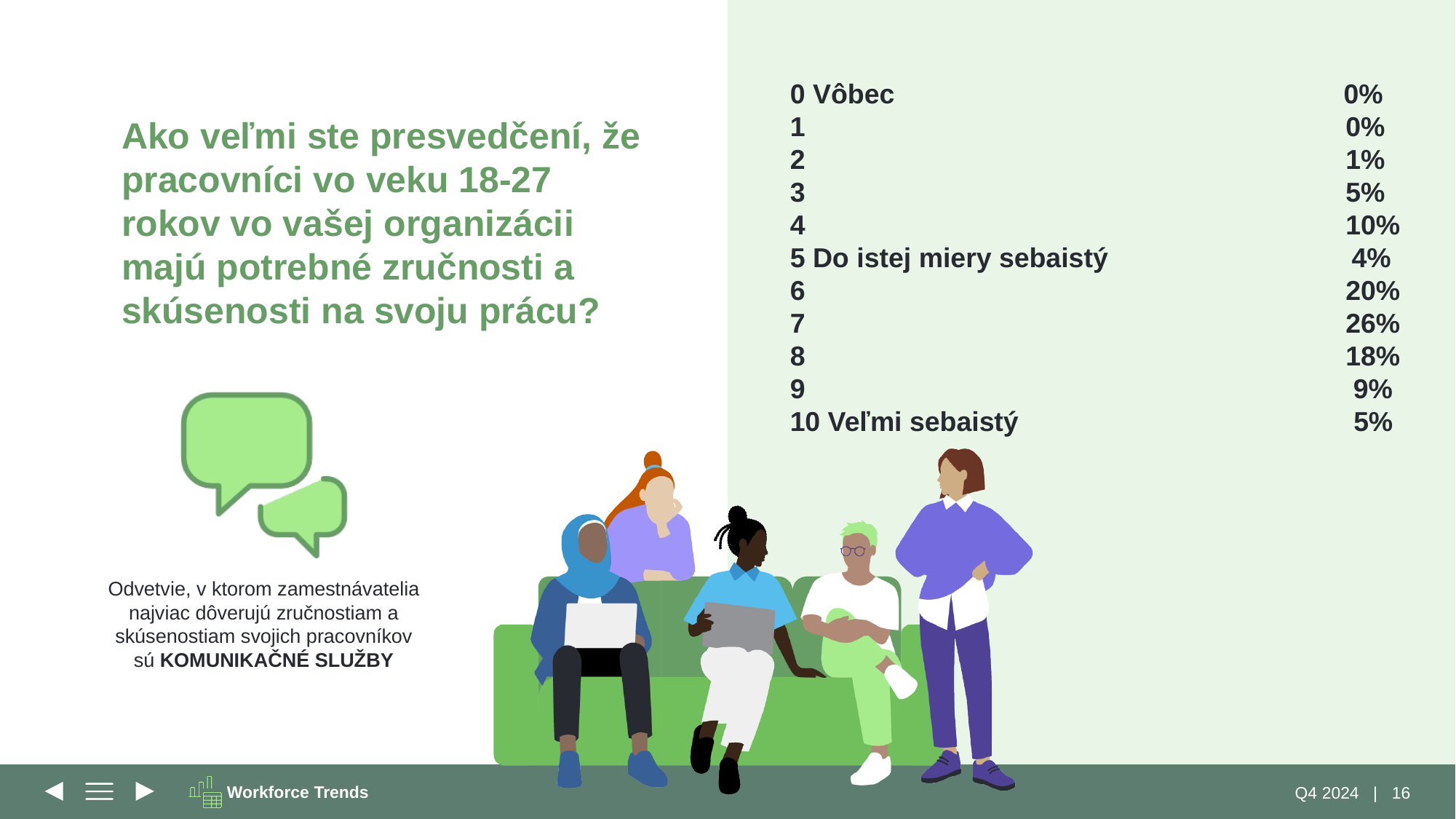
What percentage of respondents chose rating 4? 10% Which has a larger percentage, rating 4 or rating 9? 4 What percentage of respondents chose '10 Veľmi sebaistý'? 5% What percentage of respondents chose '5 Do istej miery sebaistý'? 4% Which rating has the highest percentage among ratings 8, 9 and 10? 8 Which has a larger percentage, rating 6 or rating 8? 6 What is the combined percentage for ratings 6, 7 and 8? 64% What is the difference between the percentages for rating 7 and rating 8? 8% Which rating has the highest percentage of respondents? 7 What is the difference between the percentages for rating 6 and rating 9? 11% How many rating categories are listed? 11 What percentage of respondents chose rating 7? 26%